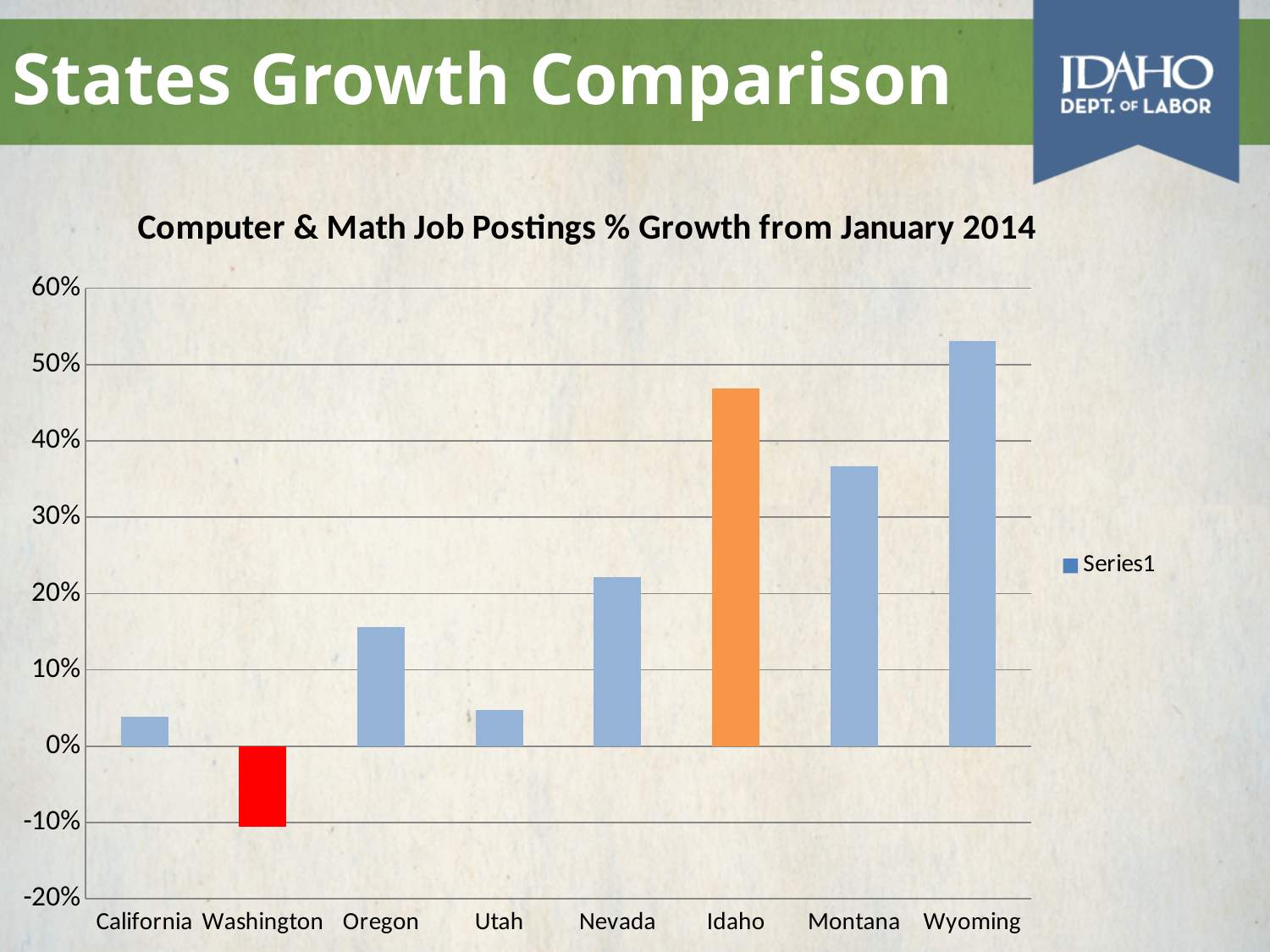
Is the value for Washington greater or less than 0%? less Is the value for Wyoming greater or less than 50%? greater Which state has the larger growth, Idaho or Montana? Idaho How many states are shown on the x axis of the chart? 8 Is the value for Utah greater or less than 10%? less What colour is the bar for Idaho? orange Which state has the lowest growth in the chart? Washington How many series does the legend list? 1 What type of chart is shown on the slide? bar chart What is the title of the chart? Computer & Math Job Postings % Growth from January 2014 Which state has the highest growth in the chart? Wyoming